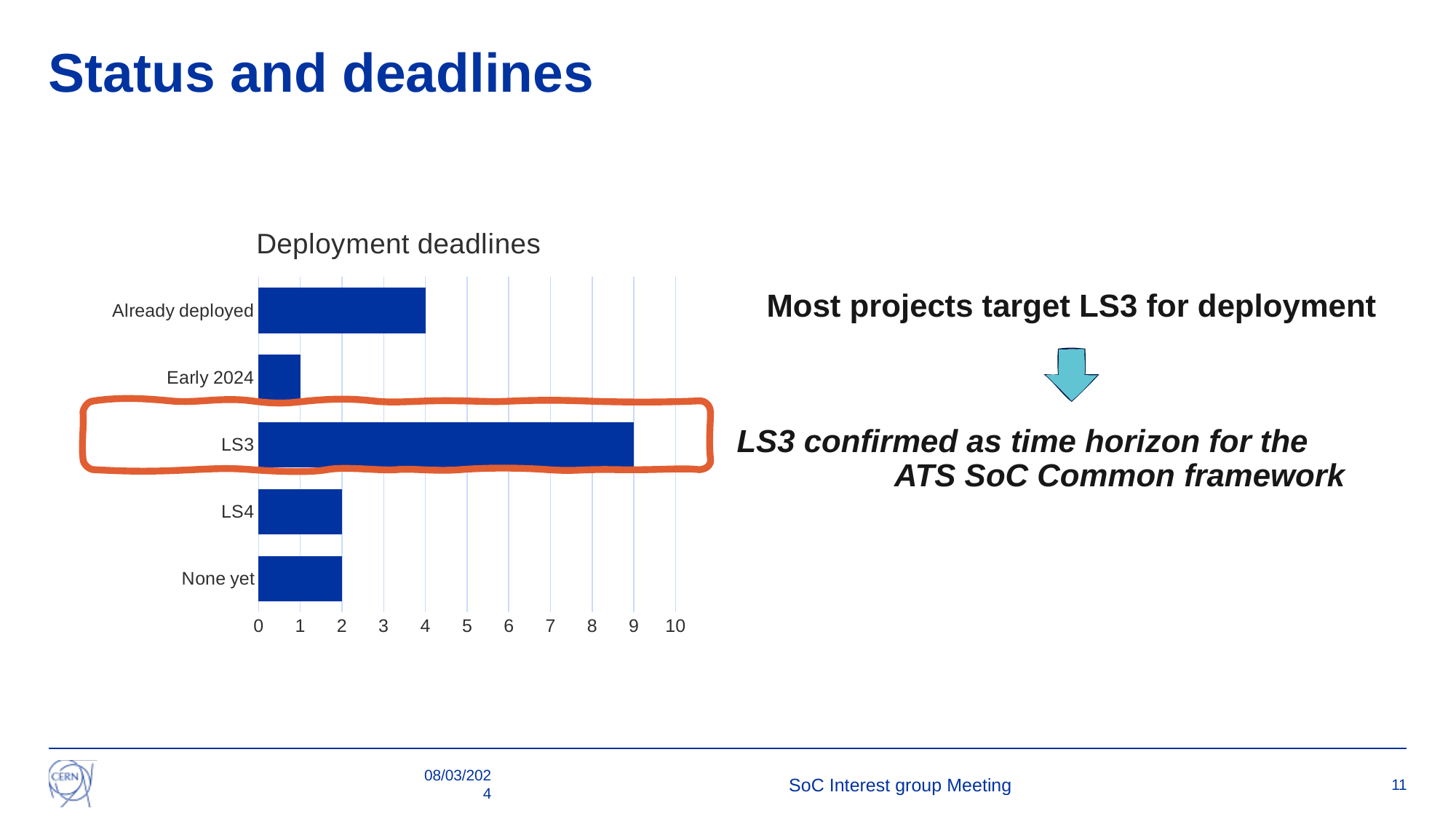
Is the value for LS3 greater or less than 8? greater What is the value for Early 2024? 1 What kind of chart is shown on the slide? bar chart What is the value for Already deployed? 4 What is the value for LS4? 2 What is the title of the chart? Deployment deadlines Which category has the highest value? LS3 Which category has the lowest value? Early 2024 How many categories does the chart show? 5 What is the difference between the values for LS3 and Already deployed? 5 Which is larger, the value for Already deployed or the value for LS4? Already deployed What is the value for LS3? 9